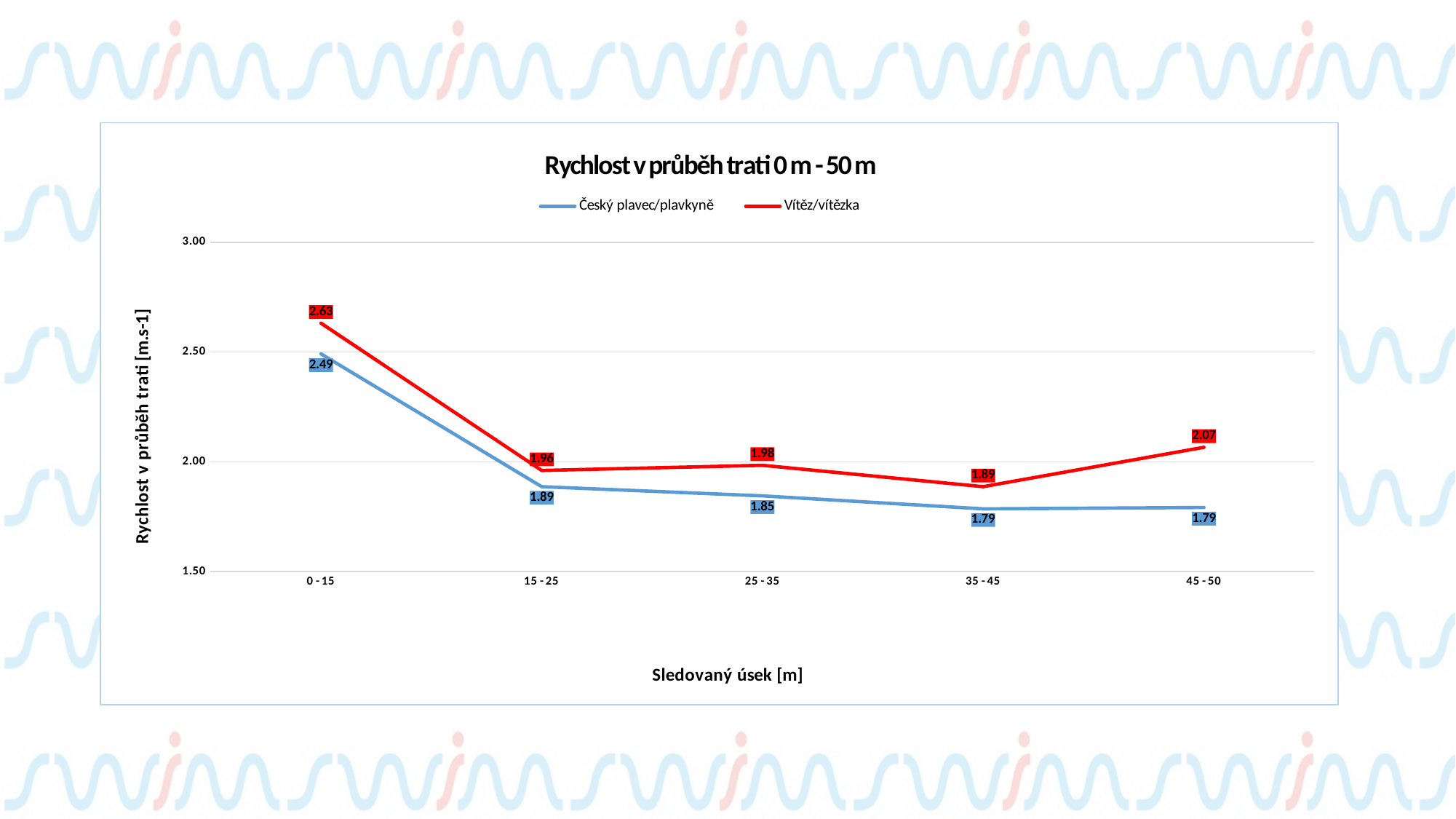
How many series does the legend list? 2 What is the value for Vítěz/vítězka in the 25 - 35 segment? 1.98 What is the value for Český plavec/plavkyně in the 0 - 15 segment? 2.49 Which series has the larger value in the 35 - 45 segment, Český plavec/plavkyně or Vítěz/vítězka? Vítěz/vítězka How many segments are shown on the x axis? 5 Is the value for Český plavec/plavkyně in the 15 - 25 segment greater or less than 2.00? less What is the value for Vítěz/vítězka in the 45 - 50 segment? 2.07 Does the value for Český plavec/plavkyně rise or fall from the 0 - 15 segment to the 15 - 25 segment? fall What is the difference between Vítěz/vítězka and Český plavec/plavkyně in the 0 - 15 segment? 0.14 What type of chart is shown on the slide? line chart In which segment is the value for Vítěz/vítězka highest? 0 - 15 In which segment is the value for Vítěz/vítězka lowest? 35 - 45